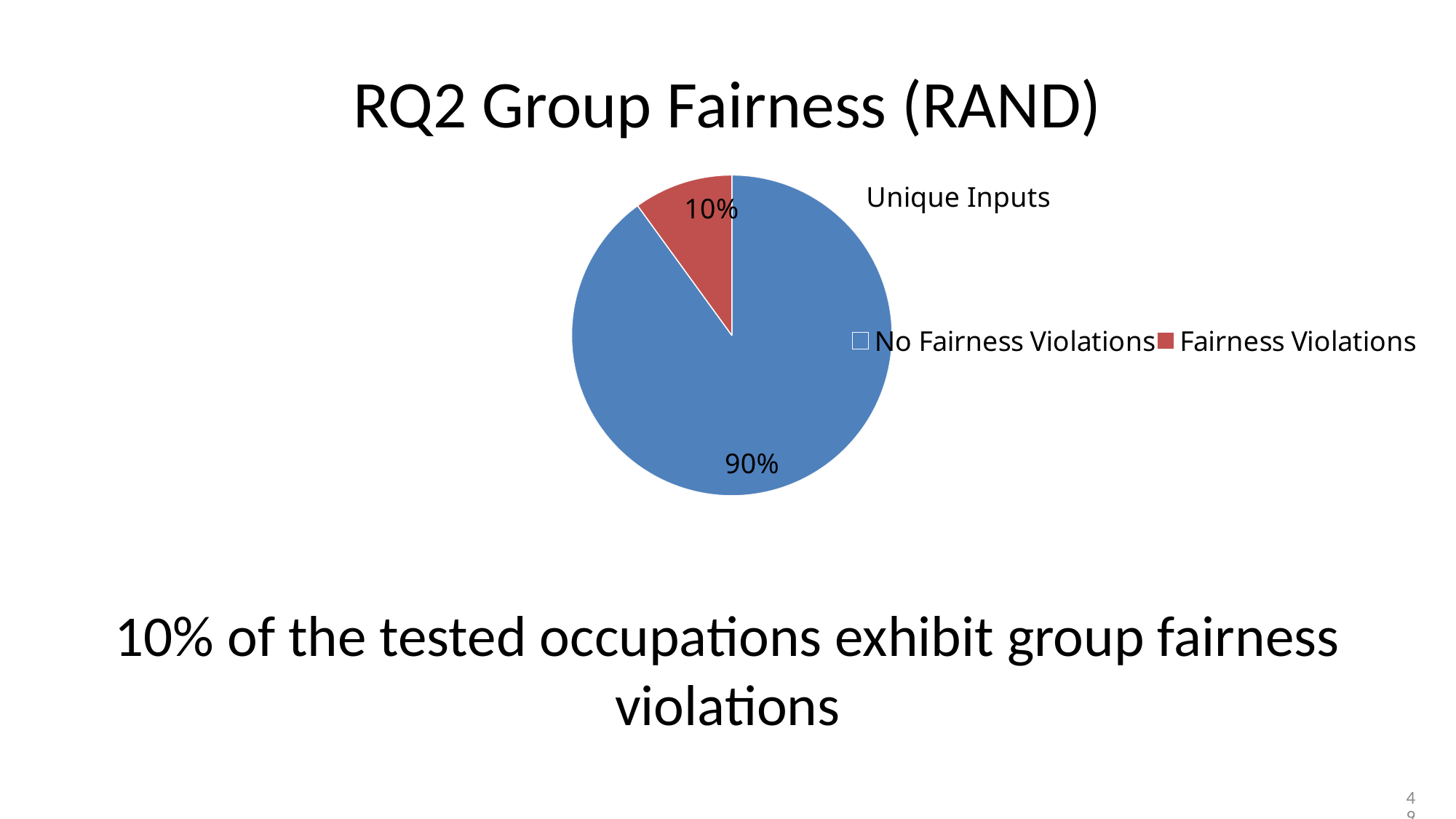
What colour is the Fairness Violations slice? red How many entries does the legend list? 2 How many slices does the pie chart have? 2 What is the difference in percentage points between the No Fairness Violations slice and the Fairness Violations slice? 80 What kind of chart is shown on the slide? pie chart Which slice is the smallest? Fairness Violations What is the chart's title? Unique Inputs What share of the pie is labelled Fairness Violations? 10% Which slice is the largest? No Fairness Violations What share of the pie is labelled No Fairness Violations? 90% Which is larger, the Fairness Violations slice or the No Fairness Violations slice? No Fairness Violations